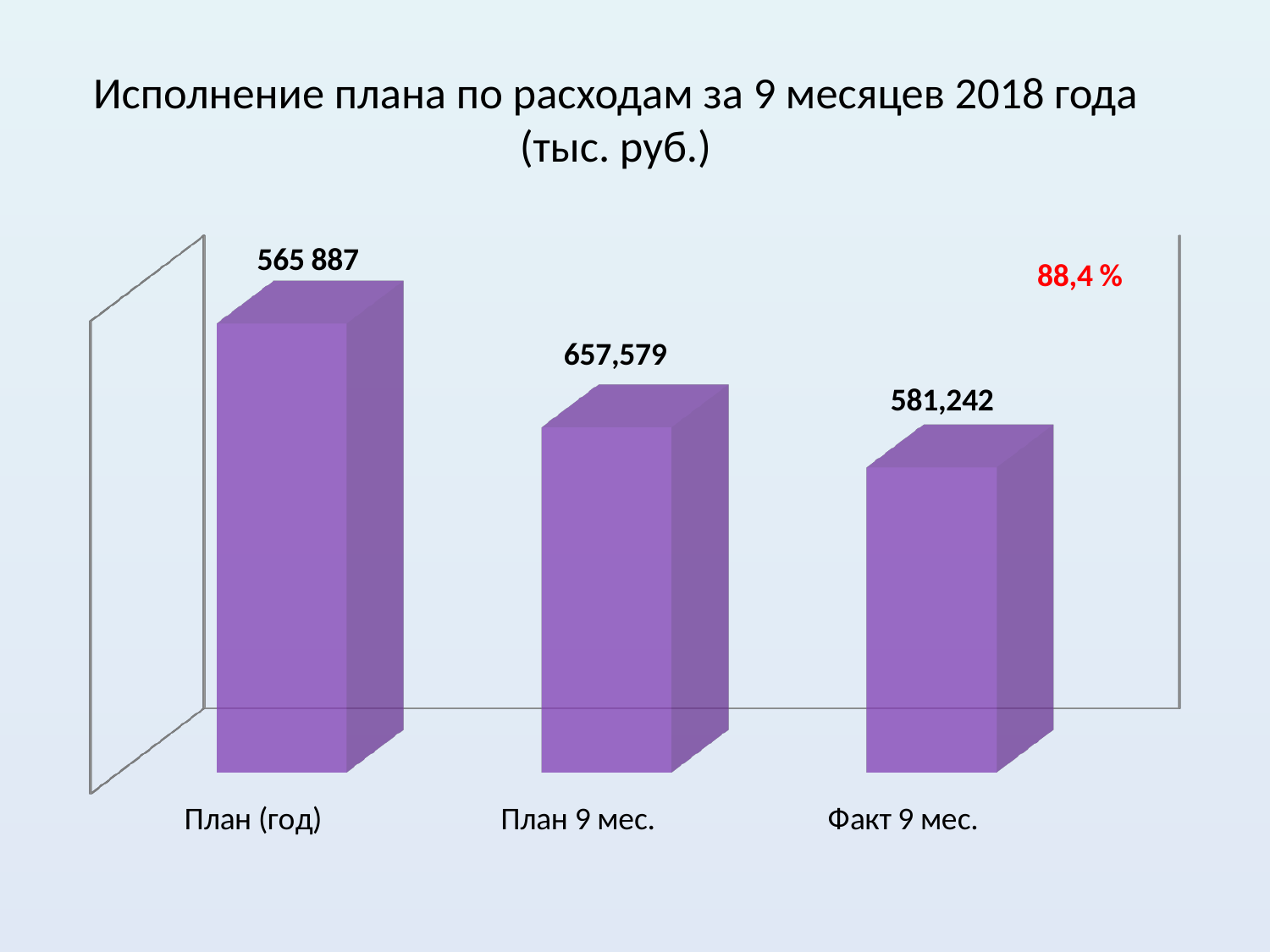
What is the value for План (год)? 565 887 What percentage is shown in red on the chart? 88,4 % What is the difference between the values for План 9 мес. and Факт 9 мес.? 76,337 What is the value for План 9 мес.? 657,579 What is the title of the chart? Исполнение плана по расходам за 9 месяцев 2018 года (тыс. руб.) How many categories are shown on the chart? 3 What kind of chart is shown on the slide? Bar chart What is the label of the third category on the x axis? Факт 9 мес. Which is larger, the value for План 9 мес. or the value for Факт 9 мес.? План 9 мес. What is the value for Факт 9 мес.? 581,242